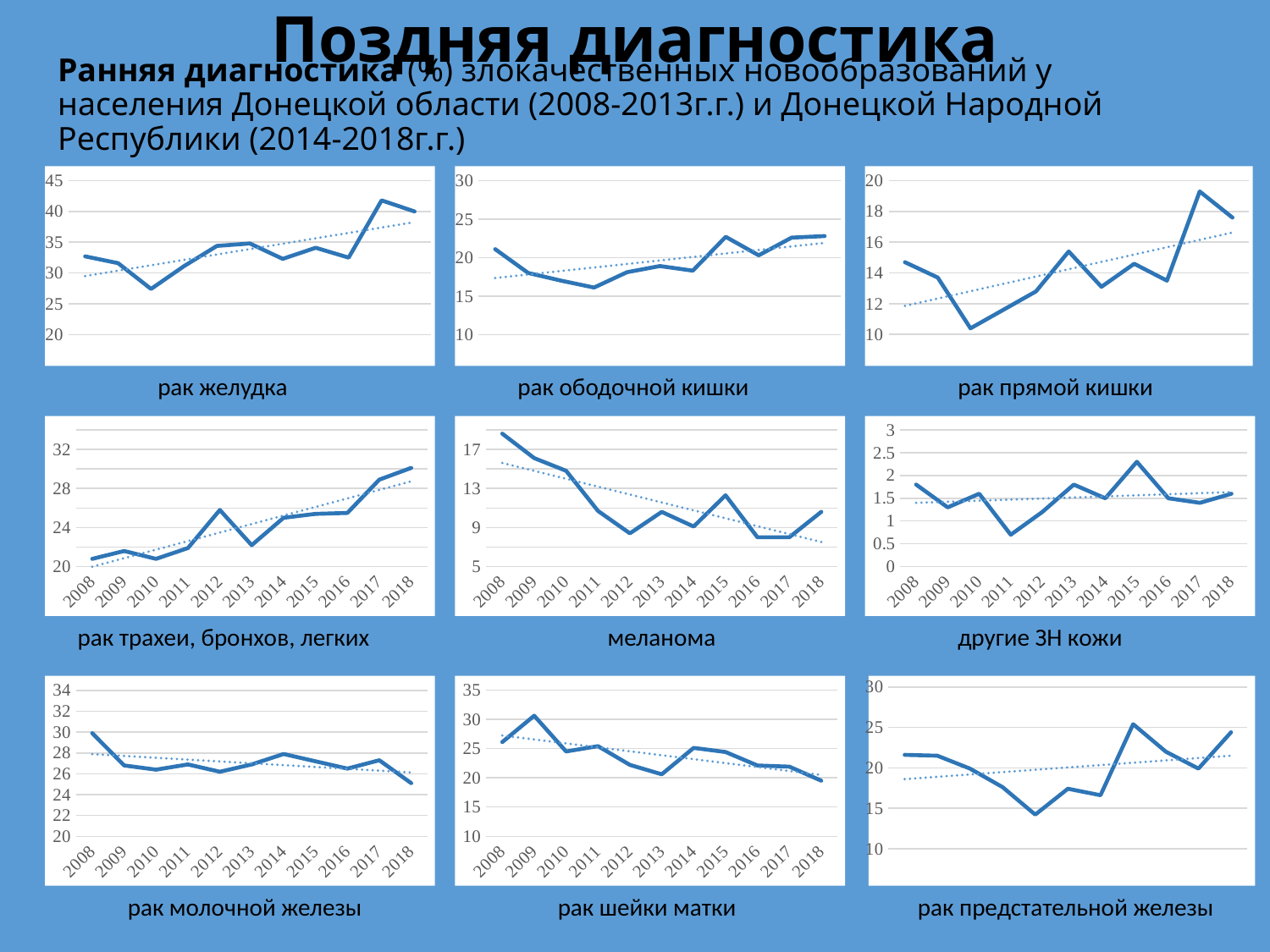
In the "рак желудка" chart, is the value for 2010 greater or less than 30? less What kind of chart is used for "рак желудка"? line chart In the "меланома" chart, which year has the highest value? 2008 In the "рак трахеи, бронхов, легких" chart, do the values generally rise or fall from 2008 to 2018? rise In the "рак прямой кишки" chart, is the value for 2017 greater or less than 18? greater In the "рак шейки матки" chart, is the value for 2009 greater or less than 30? greater In the "другие ЗН кожи" chart, which year has the lowest value? 2011 In the "рак предстательной железы" chart, which year has the lowest value? 2012 In the "рак молочной железы" chart, which is larger, the value for 2008 or the value for 2018? 2008 How many charts are shown on the slide? 9 In the "рак ободочной кишки" chart, which year has the lowest value? 2011 In the "рак желудка" chart, which year has the highest value? 2017